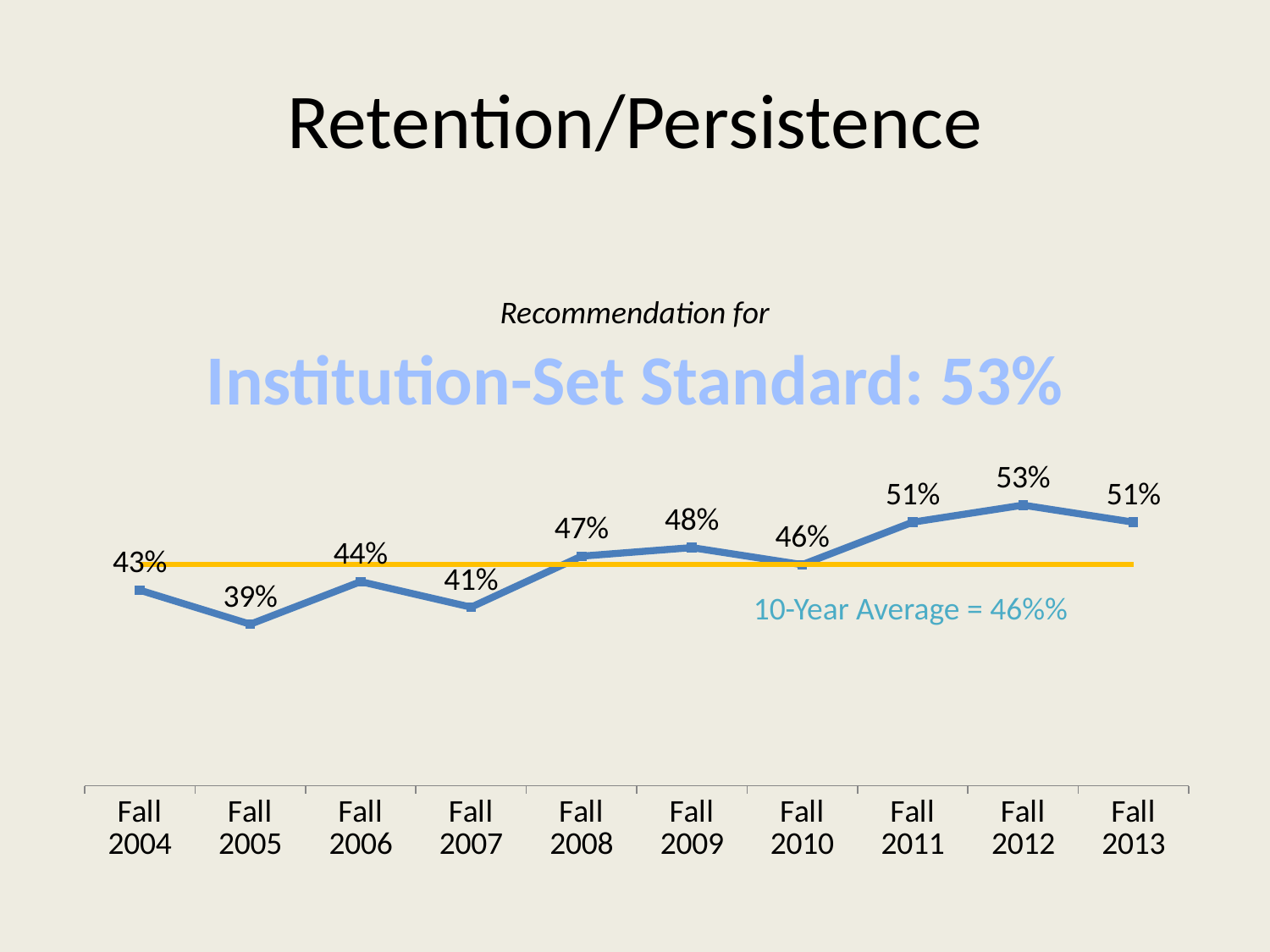
What is the difference between the Fall 2012 value and the Fall 2005 value? 14% What kind of chart is shown on the slide? line chart What is the retention/persistence value for Fall 2009? 48% How many terms are plotted on the x axis? 10 Which term has the highest retention/persistence value? Fall 2012 Do the values generally rise or fall from Fall 2004 to Fall 2013? rise What value does the horizontal line labelled 10-Year Average represent? 46% Which is larger, the value for Fall 2006 or the value for Fall 2010? Fall 2010 Which term has the lowest retention/persistence value? Fall 2005 What is the difference between the Fall 2008 value and the Fall 2007 value? 6% What is the retention/persistence value for Fall 2013? 51% What is the retention/persistence value for Fall 2004? 43%